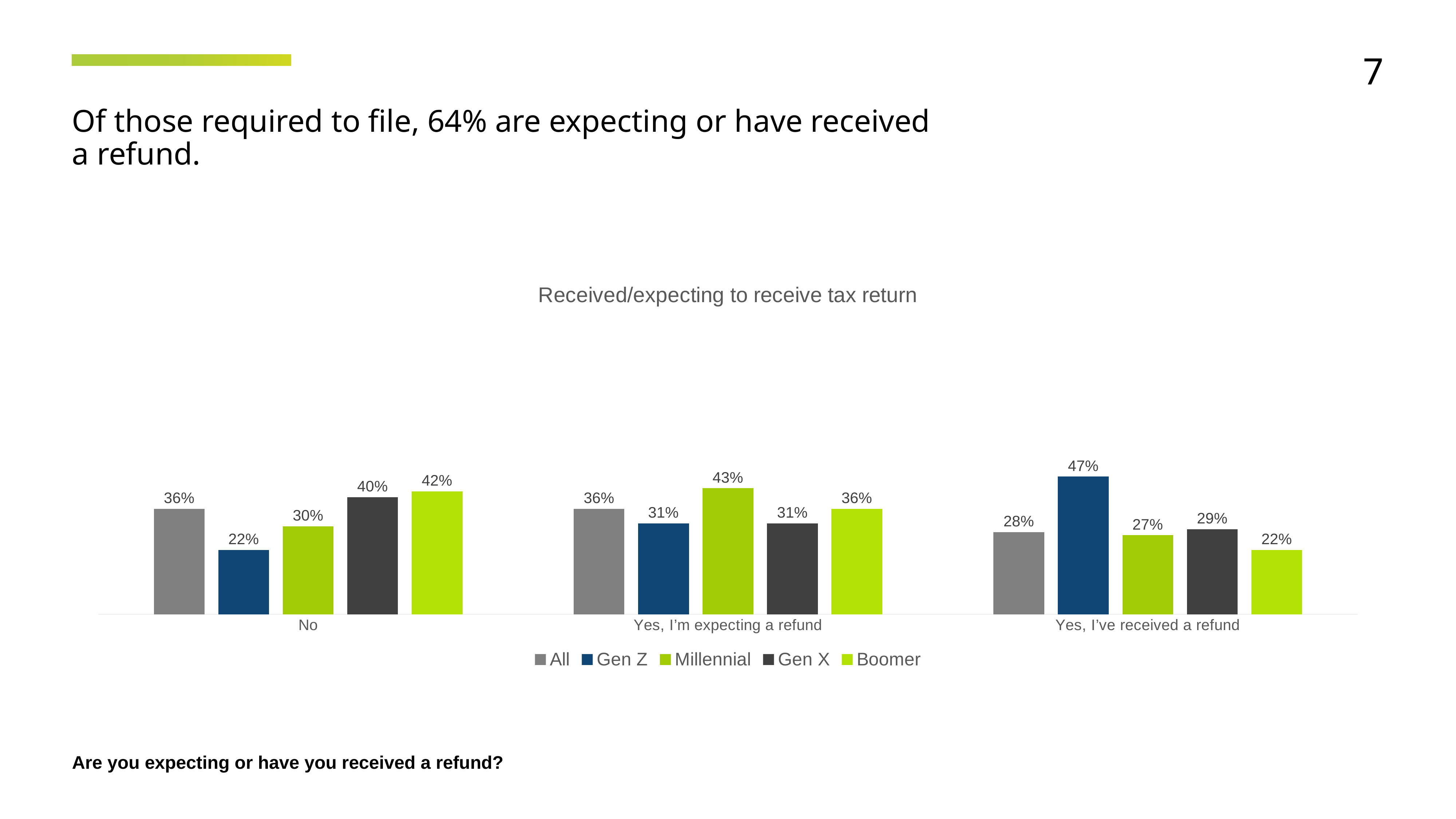
What is the value for Millennial in the "Yes, I'm expecting a refund" category? 43% Which series has the highest value in the "Yes, I've received a refund" category? Gen Z How many categories are shown on the x axis? 3 What is the difference between the Gen Z and Millennial values in the "Yes, I've received a refund" category? 20% What kind of chart is shown on the slide? Bar chart What is the value for Boomer in the "Yes, I've received a refund" category? 22% How many series does the legend list? 5 What is the title of the chart? Received/expecting to receive tax return What is the value for Gen Z in the "No" category? 22% Which is larger in the "Yes, I'm expecting a refund" category: Millennial or Gen X? Millennial What is the difference between the Boomer and Gen Z values in the "No" category? 20% Which series has the lowest value in the "No" category? Gen Z